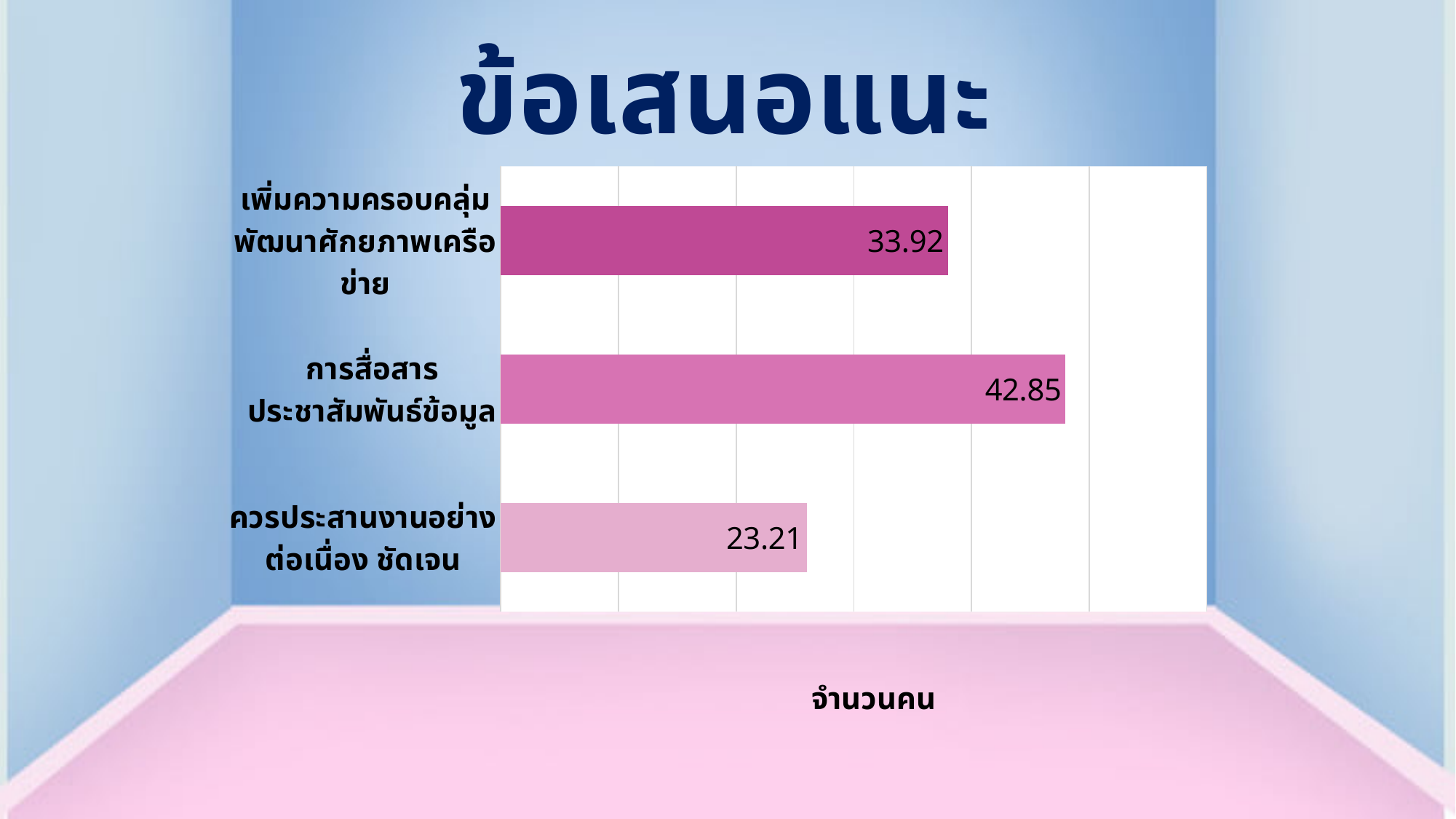
What is the difference between the values for เพิ่มความครอบคลุมพัฒนาศักยภาพเครือข่าย and ควรประสานงานอย่างต่อเนื่อง ชัดเจน? 10.71 What is the difference between the values for การสื่อสารประชาสัมพันธ์ข้อมูล and ควรประสานงานอย่างต่อเนื่อง ชัดเจน? 19.64 Which category has the highest value? การสื่อสารประชาสัมพันธ์ข้อมูล Which is larger: the value for เพิ่มความครอบคลุมพัฒนาศักยภาพเครือข่าย or the value for ควรประสานงานอย่างต่อเนื่อง ชัดเจน? เพิ่มความครอบคลุมพัฒนาศักยภาพเครือข่าย What is the title of the slide? ข้อเสนอแนะ Which category has the lowest value? ควรประสานงานอย่างต่อเนื่อง ชัดเจน How many categories are shown in the chart? 3 What is the value for ควรประสานงานอย่างต่อเนื่อง ชัดเจน? 23.21 What is the difference between the values for การสื่อสารประชาสัมพันธ์ข้อมูล and เพิ่มความครอบคลุมพัฒนาศักยภาพเครือข่าย? 8.93 What is the value for การสื่อสารประชาสัมพันธ์ข้อมูล? 42.85 What is the value for เพิ่มความครอบคลุมพัฒนาศักยภาพเครือข่าย? 33.92 What kind of chart is shown on the slide? Bar chart